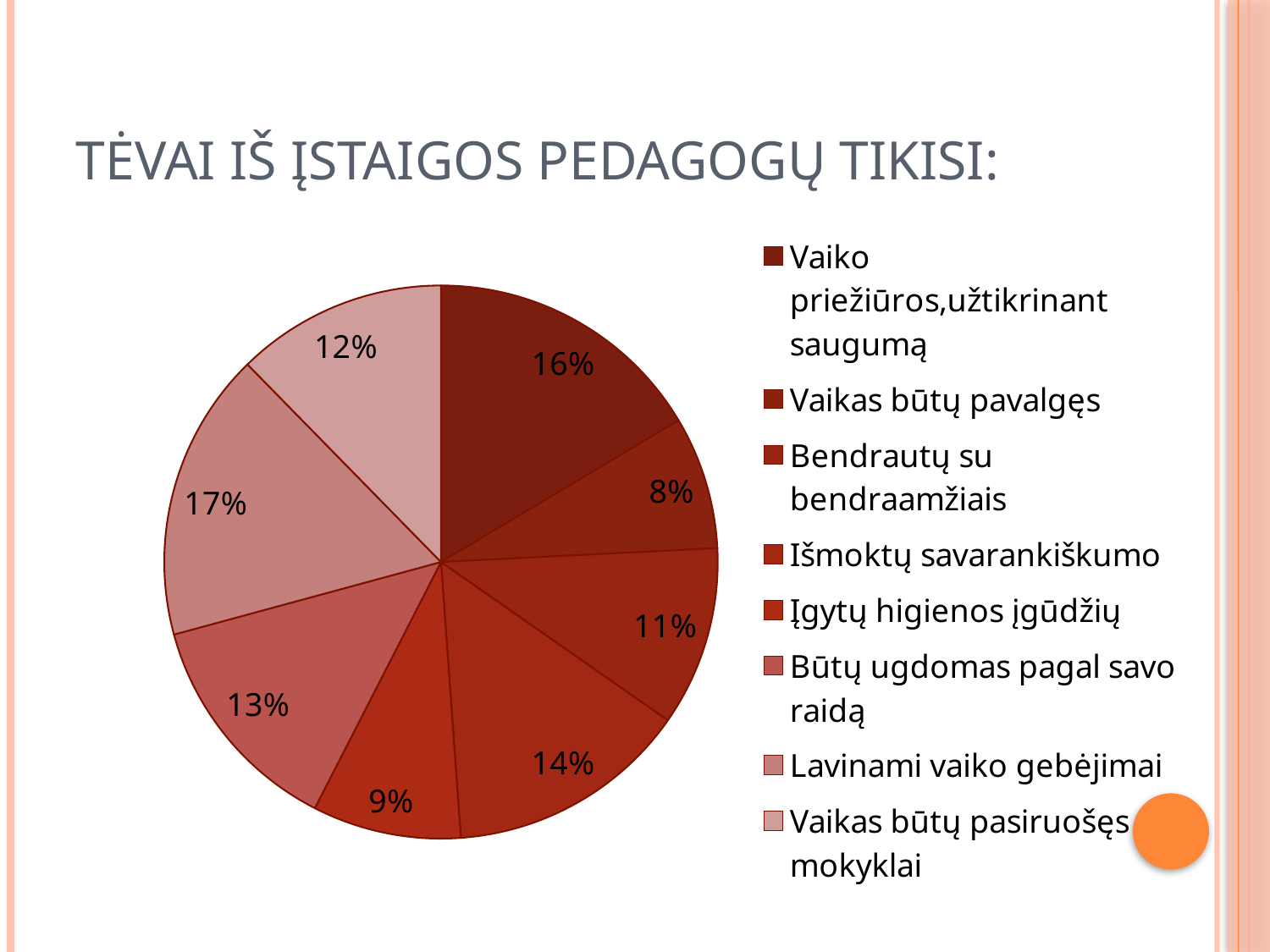
Which is larger, the 14% slice or the 11% slice? the 14% slice What is the largest percentage shown on the pie chart? 17% What is the smallest percentage shown on the pie chart? 8% How many slices does the pie chart have? 8 What is the difference between the largest slice (17%) and the smallest slice (8%)? 9% What share of the pie does 'Vaiko priežiūros, užtikrinant saugumą' have? 16% What kind of chart is shown on the slide? pie chart What share of the pie does 'Lavinami vaiko gebėjimai' have? 17% What share of the pie does 'Vaikas būtų pasiruošęs mokyklai' have? 12% How many entries does the legend list? 8 What is the title of the slide? TĖVAI IŠ ĮSTAIGOS PEDAGOGŲ TIKISI: